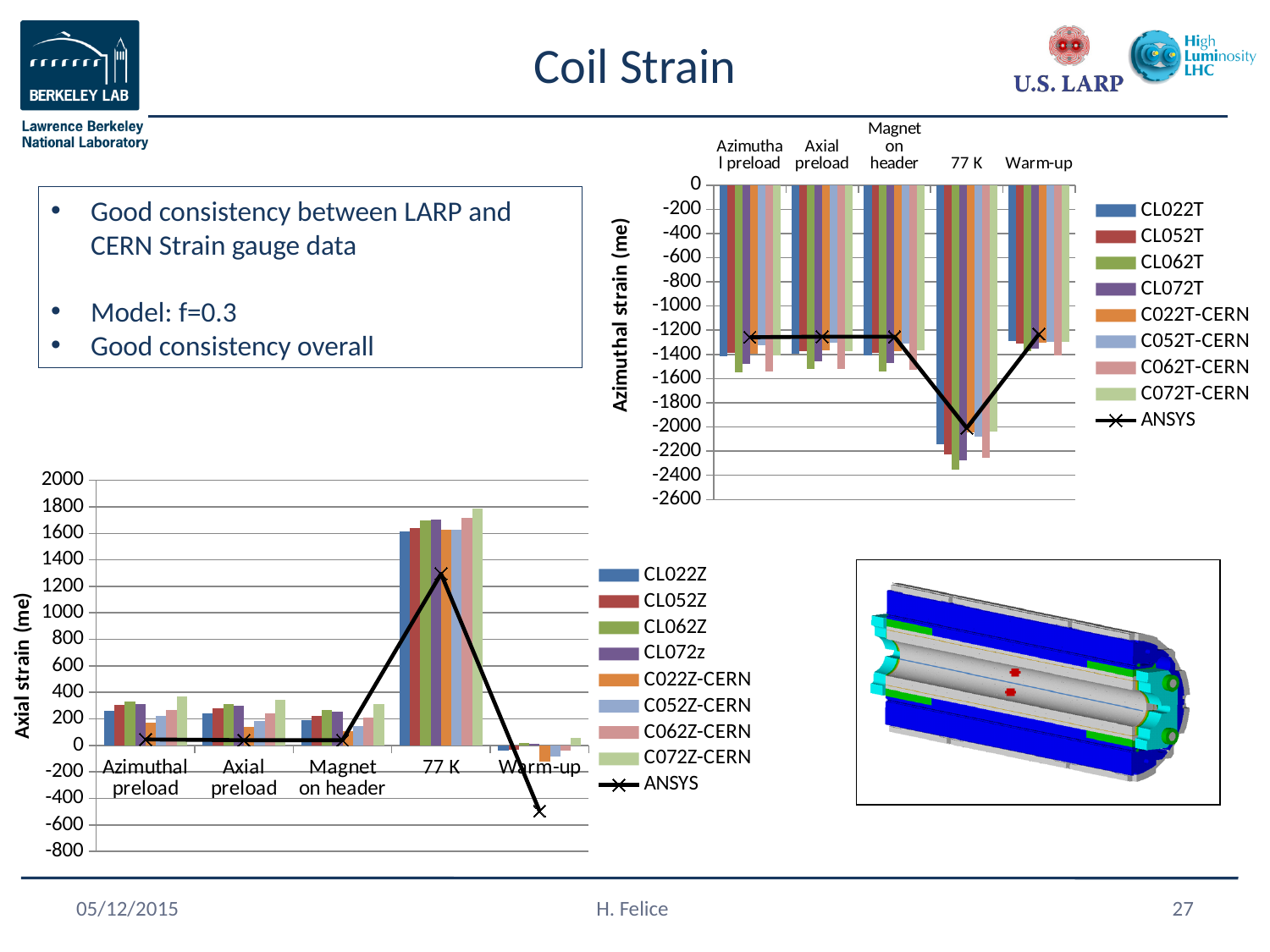
What kind of chart is the Axial strain chart at the bottom left? Bar chart (with an ANSYS line series) How many series does the legend of the Azimuthal strain chart at the top right list? 9 In the Axial strain chart, is the value of CL022Z at 77 K greater or less than 1400? greater In the Azimuthal strain chart, is the value of CL062T at 77 K greater or less than -2000? less In the Azimuthal strain chart, which category has the lowest (most negative) bars? 77 K In the Axial strain chart, which is larger: the CL022Z value at 77 K or the CL022Z value at Axial preload? CL022Z at 77 K In the Azimuthal strain chart, is the value of CL022T at Azimuthal preload greater or less than -1000? less In the Axial strain chart, which category has the highest bars? 77 K How many categories are shown on the x axis of the Axial strain chart at the bottom left? 5 How many series does the legend of the Axial strain chart at the bottom left list? 9 Which series is drawn as a line with x markers in both charts? ANSYS